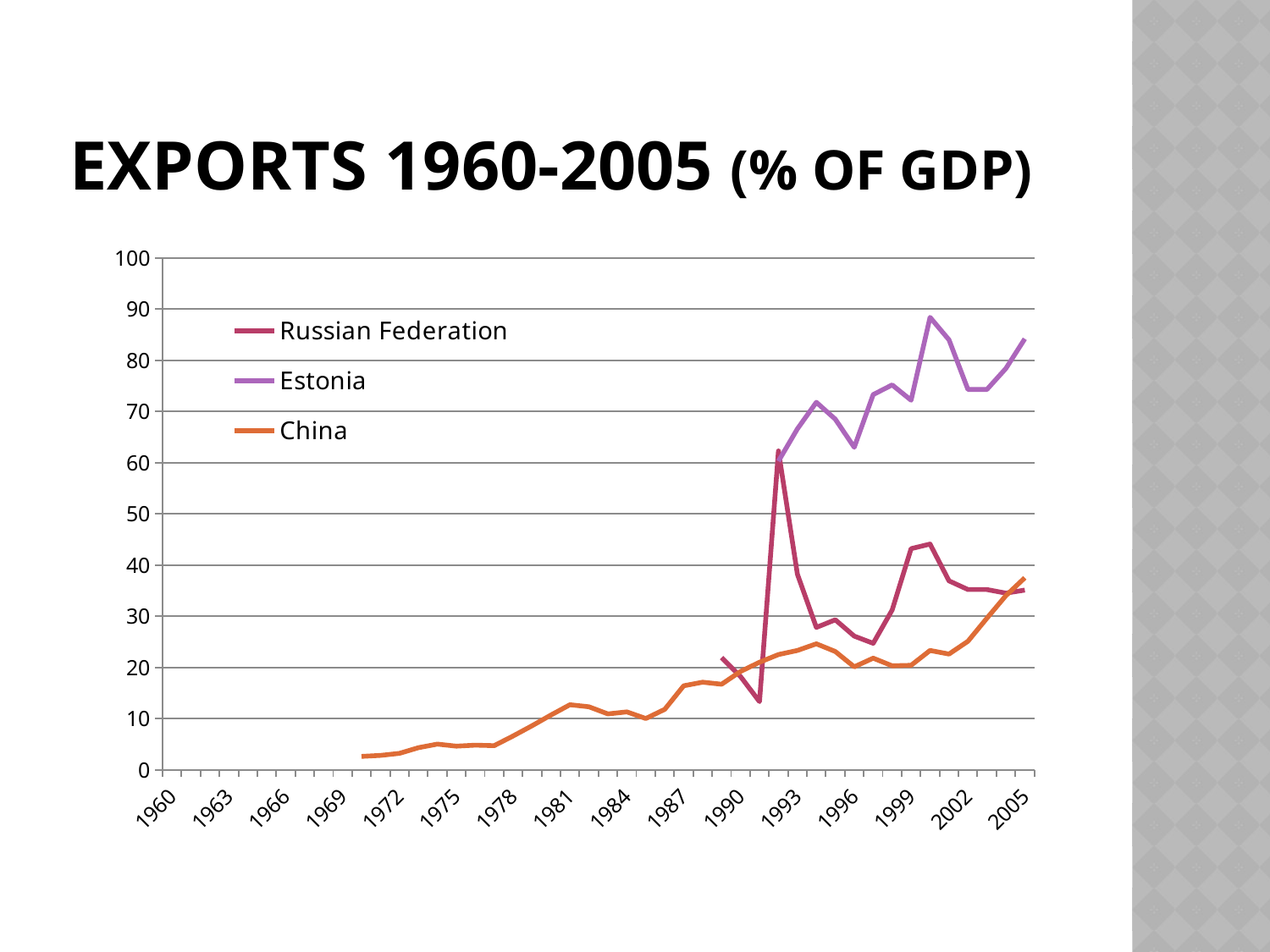
Is the value for the Russian Federation in 1993 greater or less than 50? less What is the title of the chart? Exports 1960-2005 (% of GDP) Is the value for Estonia in 2005 greater or less than 80? greater Is the value for Estonia in 2002 greater or less than 80? less How many series does the legend list? 3 Which series has the highest value in 2005? Estonia In 1993, which is larger: the value for the Russian Federation or the value for China? Russian Federation Which series is drawn in purple? Estonia Does the value for China generally rise or fall from 1970 to 2005? rise What kind of chart is shown on the slide? line chart